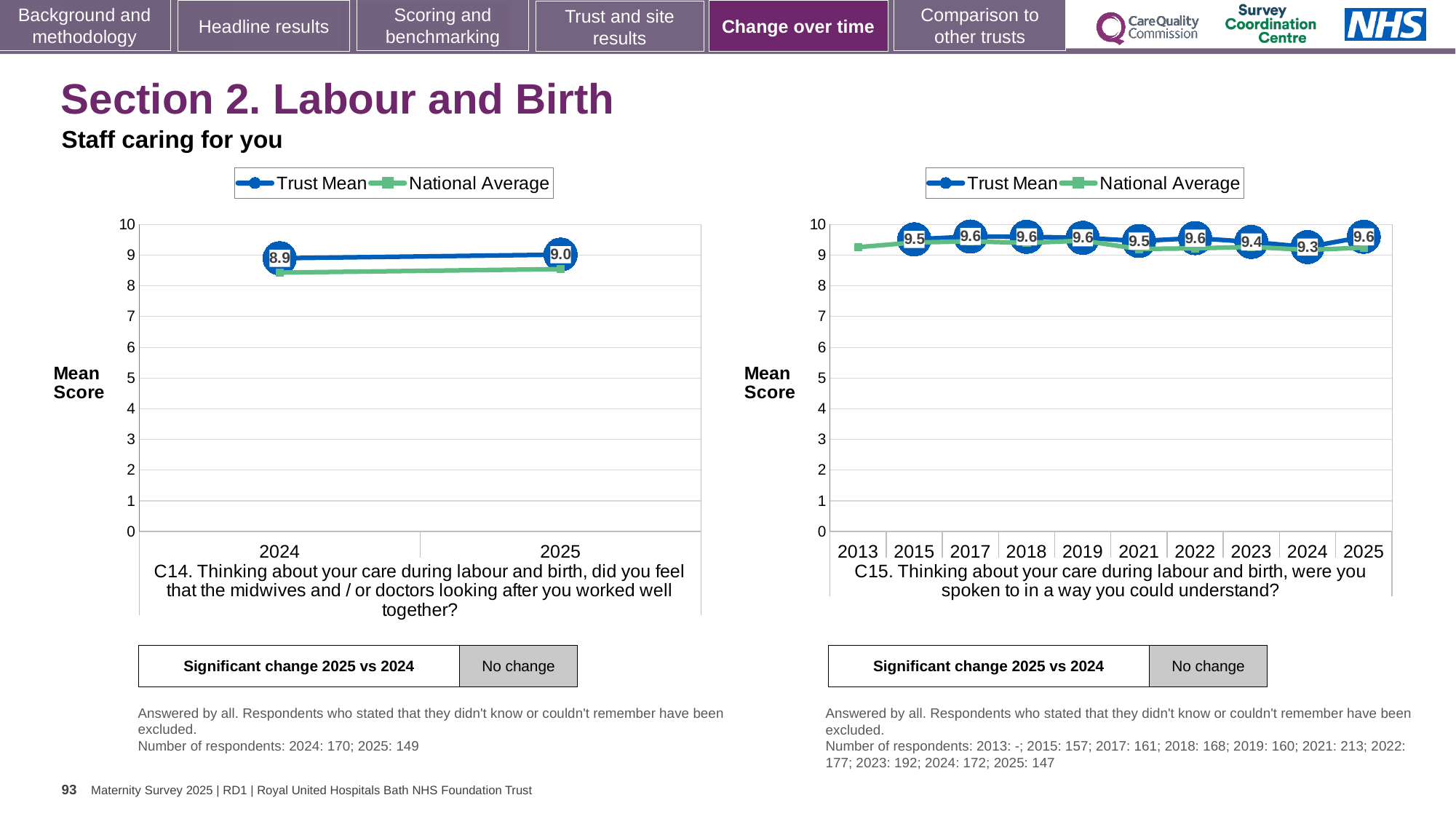
In the right chart (C15), what is the difference between the Trust Mean in 2025 and in 2024? 0.3 In the right chart (C15), is the Trust Mean for 2023 greater or less than 9? greater In the left chart (C14), what is the Trust Mean for 2024? 8.9 In the left chart (C14), what is the Trust Mean for 2025? 9.0 In the right chart (C15), what is the Trust Mean for 2024? 9.3 In the right chart (C15), what is the Trust Mean for 2025? 9.6 What type of chart is the left chart (C14)? Line chart In the right chart (C15), how many years are shown on the x axis? 10 In the right chart (C15), which year has the lowest Trust Mean? 2024 How many series does the legend of the right chart (C15) list? 2 In the left chart (C14), by how much did the Trust Mean change from 2024 to 2025? 0.1 In the left chart (C14), is the National Average for 2024 greater or less than 9? less